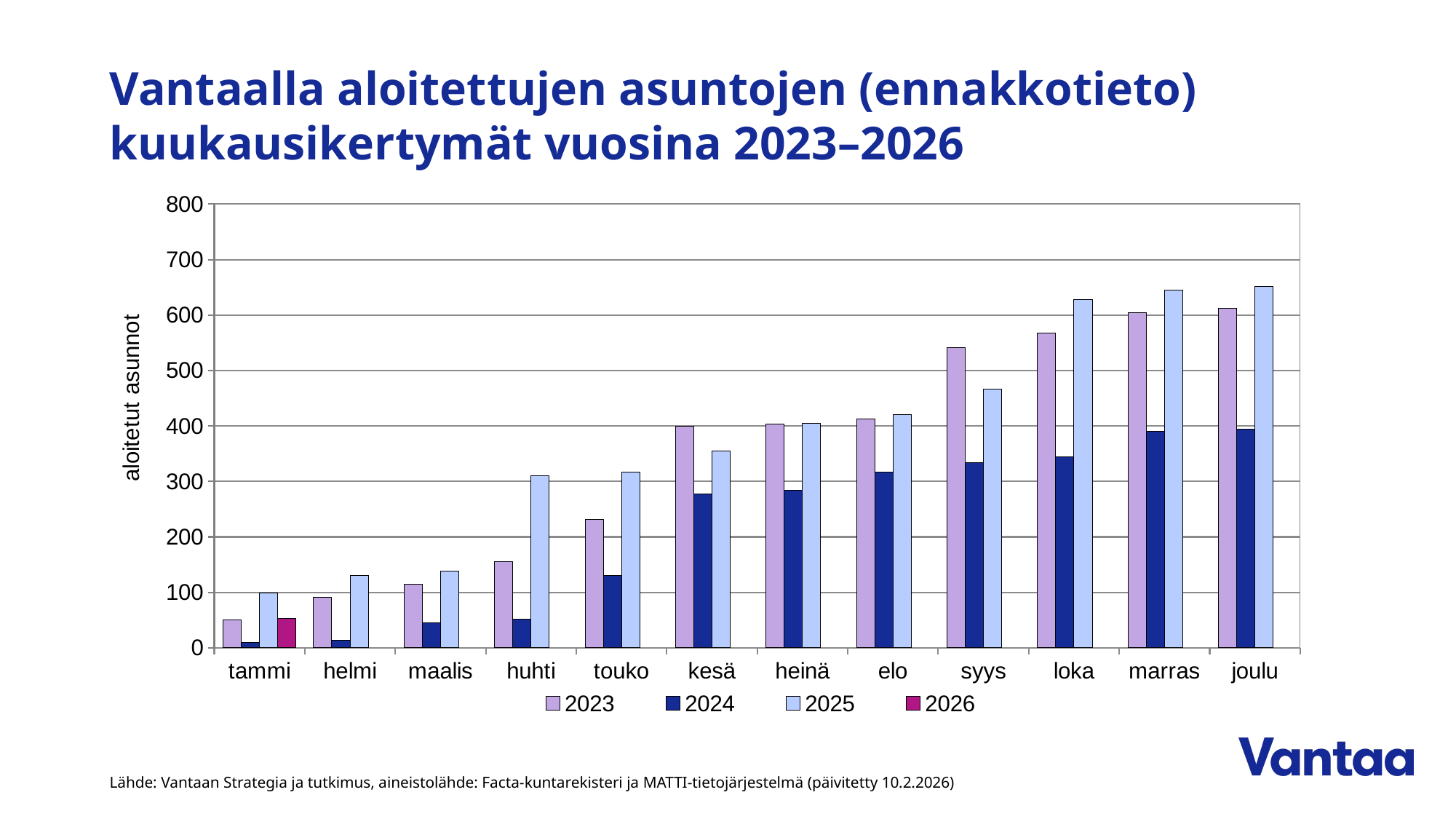
What kind of chart is shown on the slide? bar chart Is the value for 2023 in syys greater or less than 500? greater How many series does the legend list? 4 Is the value for 2024 in kesä greater or less than 300? less Do the 2025 values rise or fall from tammi to joulu? rise Which series has the highest value in joulu? 2025 In which month is the 2025 series lowest? tammi What is the label on the y axis? aloitetut asunnot In kesä, which is larger: the 2023 value or the 2025 value? 2023 Is the value for 2024 in touko greater or less than 100? greater How many months are shown on the x axis? 12